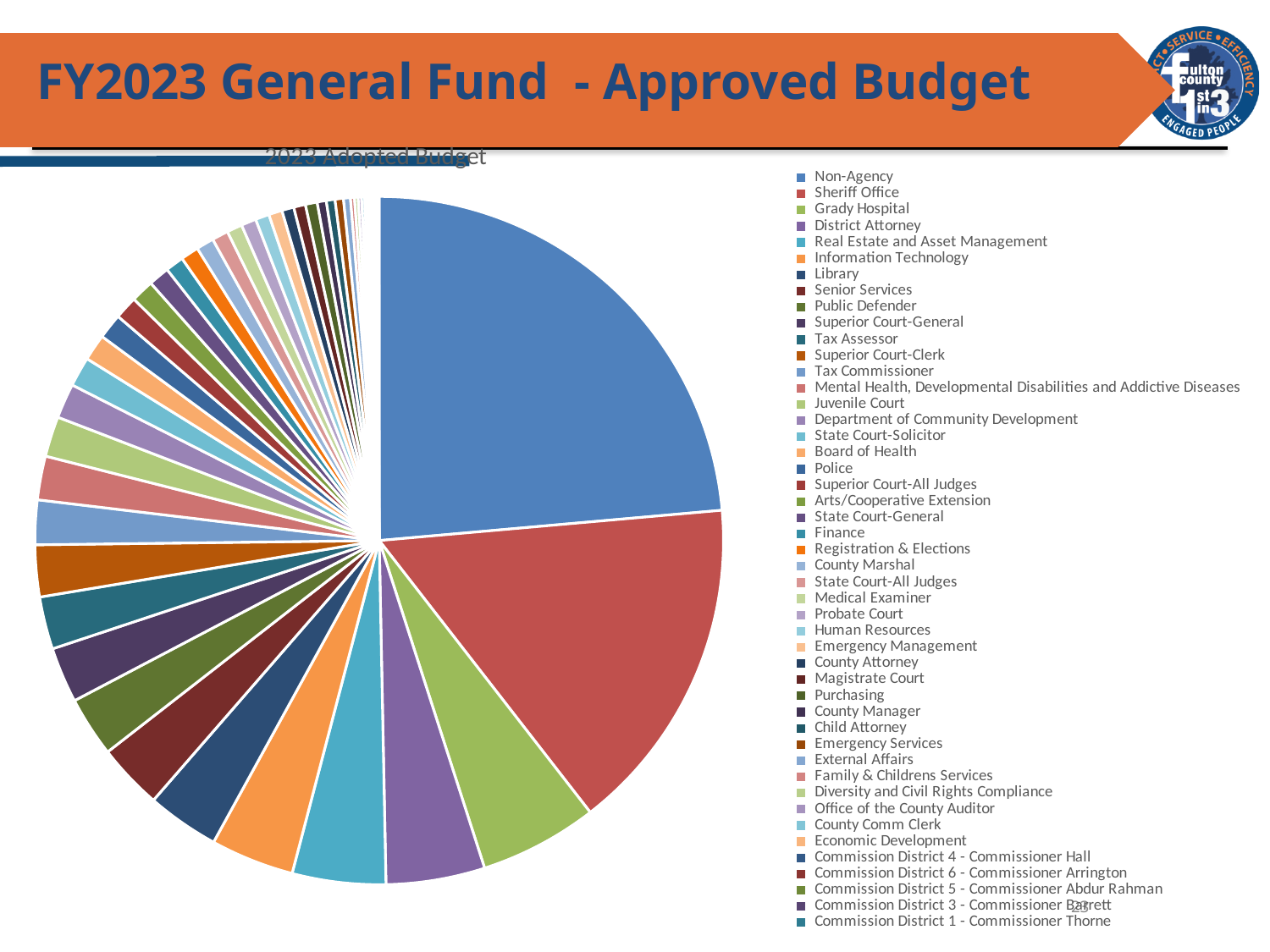
What is the title of the pie chart? 2023 Adopted Budget What kind of chart is shown on the slide? pie chart Which is larger, the slice for Sheriff Office or the slice for Grady Hospital? Sheriff Office What is the first entry listed in the legend? Non-Agency Which is larger, the slice for Non-Agency or the slice for Library? Non-Agency Which category has the second-largest slice of the pie? Sheriff Office Which is larger, the slice for Grady Hospital or the slice for District Attorney? Grady Hospital Which category has the largest slice of the pie? Non-Agency